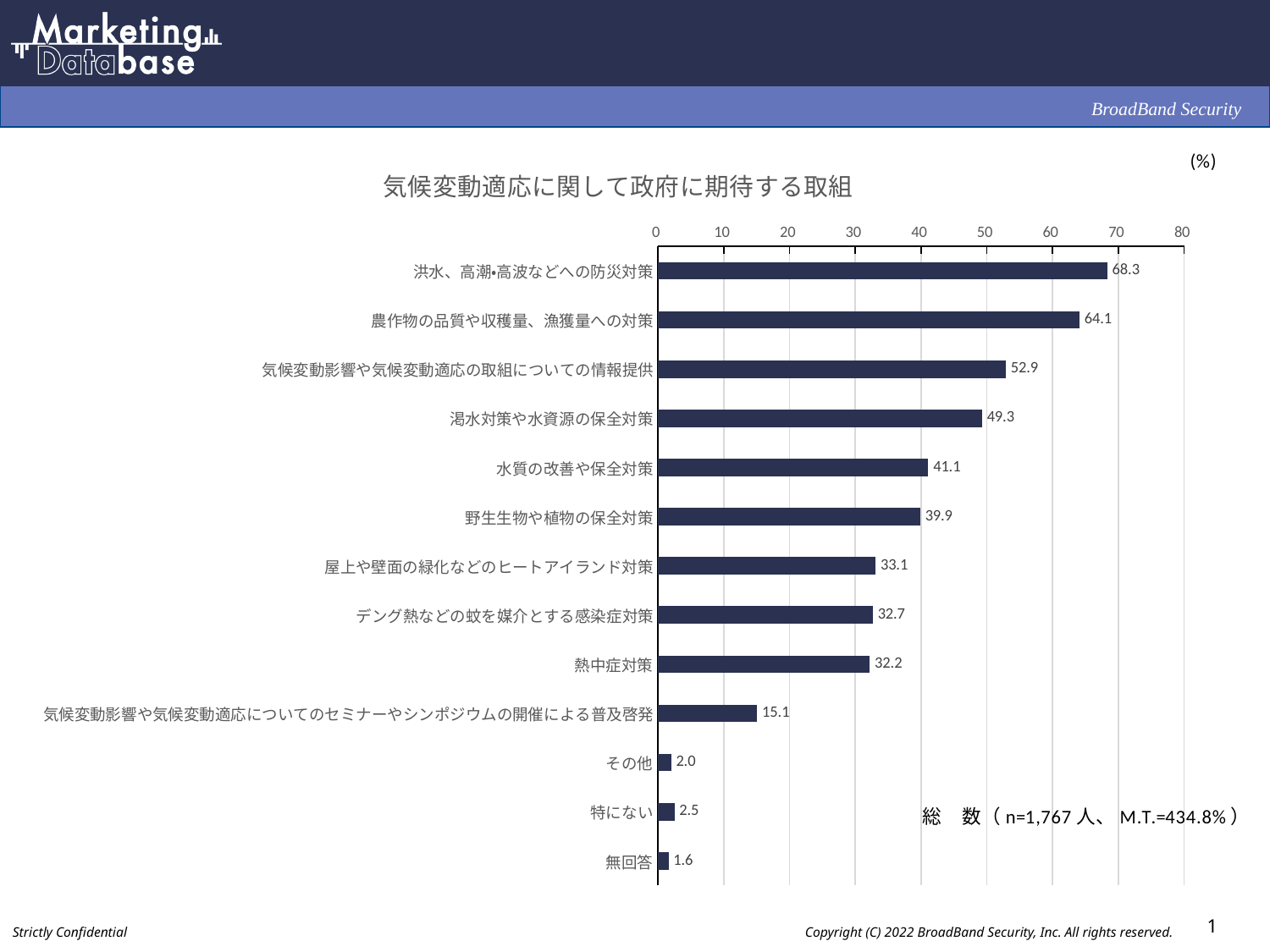
What is the value for 渇水対策や水資源の保全対策? 49.3 How many categories are plotted in the chart? 13 What is the value for 熱中症対策? 32.2 Which category has the highest value? 洪水、高潮・高波などへの防災対策 What is the sample size (n) shown on the slide? n=1,767 What is the difference between the values for 農作物の品質や収穫量、漁獲量への対策 and 気候変動影響や気候変動適応の取組についての情報提供? 11.2 What is the title of the chart? 気候変動適応に関して政府に期待する取組 What type of chart is shown on the slide? Bar chart What is the value for 気候変動影響や気候変動適応についてのセミナーやシンポジウムの開催による普及啓発? 15.1 What is the value for 洪水、高潮・高波などへの防災対策? 68.3 Which category has the lowest value? 無回答 Which is larger, the value for 水質の改善や保全対策 or the value for 屋上や壁面の緑化などのヒートアイランド対策? 水質の改善や保全対策